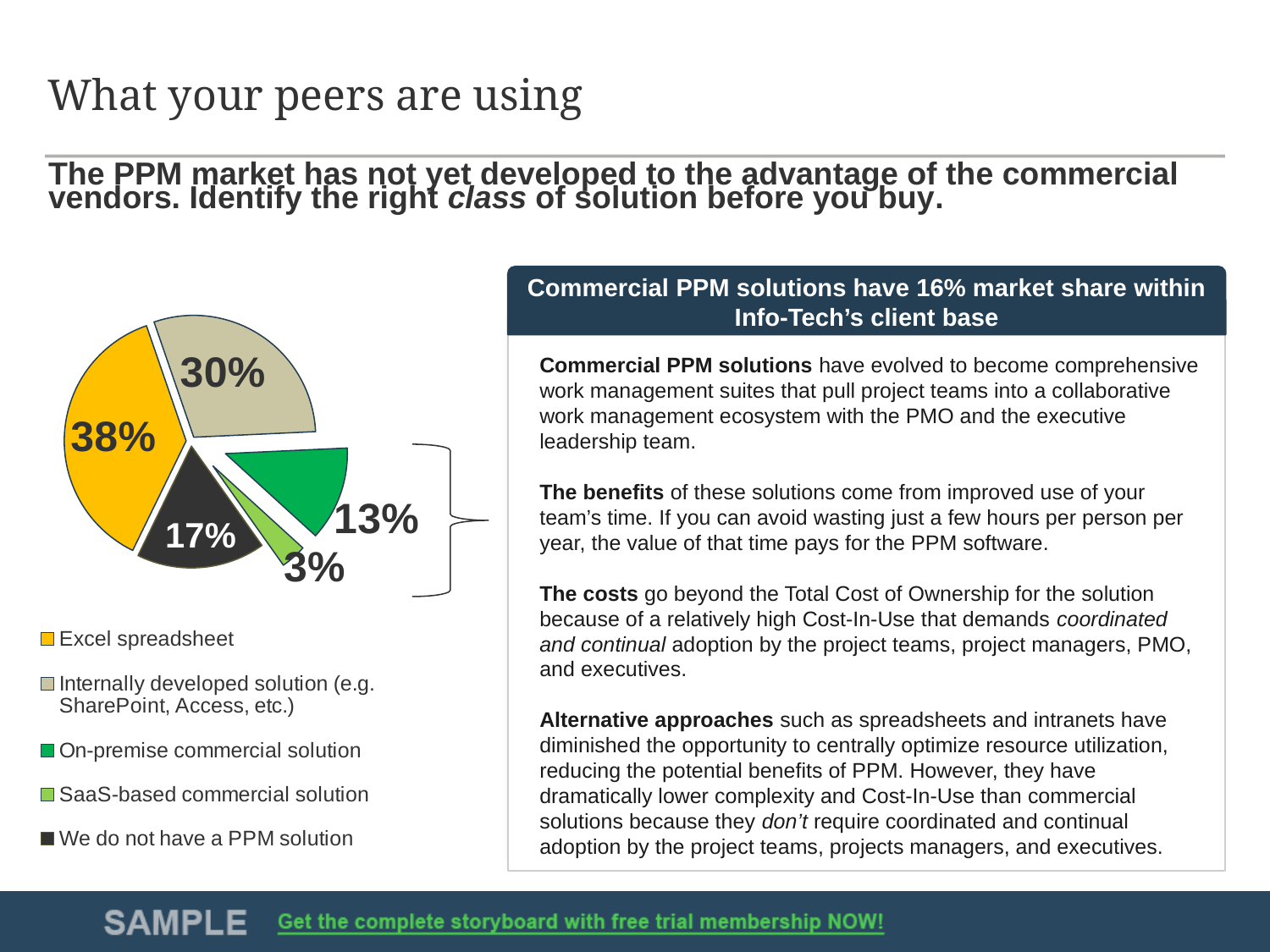
What is the difference between the Excel spreadsheet share and the Internally developed solution share? 8% What share of the pie does We do not have a PPM solution have? 17% Which category has the largest slice of the pie? Excel spreadsheet Which is larger: the share for We do not have a PPM solution or the share for On-premise commercial solution? We do not have a PPM solution How many slices does the pie chart have? 5 What share of the pie does Internally developed solution (e.g. SharePoint, Access, etc.) have? 30% Which category has the smallest slice of the pie? SaaS-based commercial solution What is the combined share of On-premise commercial solution and SaaS-based commercial solution? 16% What share of the pie does Excel spreadsheet have? 38% What kind of chart is shown on the slide? Pie chart What share of the pie does SaaS-based commercial solution have? 3% What share of the pie does On-premise commercial solution have? 13%